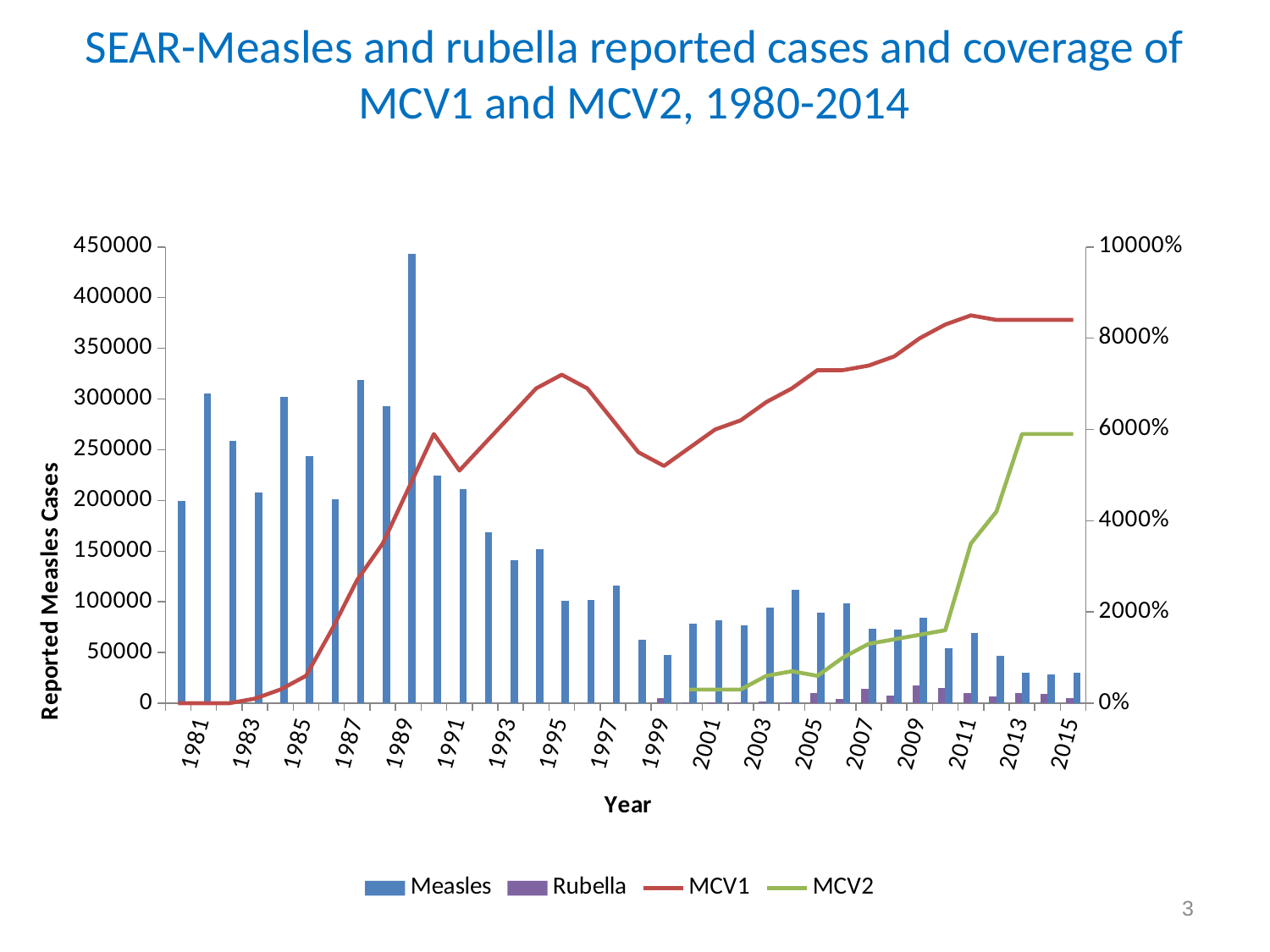
Which series are shown as lines rather than bars? MCV1 and MCV2 Does the MCV1 line generally rise or fall from 1981 to 2015? rise What kind of chart is shown on the slide? A combined bar and line chart Is the MCV1 value for 2011 greater or less than 8000%? greater Is the MCV2 value for 2011 greater or less than 4000%? less In 2013, which is higher, MCV1 or MCV2? MCV1 How many series does the legend list? 4 Is the Measles value for 2015 greater or less than 50000? less What is the title of the left vertical axis? Reported Measles Cases Which is larger, the Measles value for 1987 or for 2007? 1987